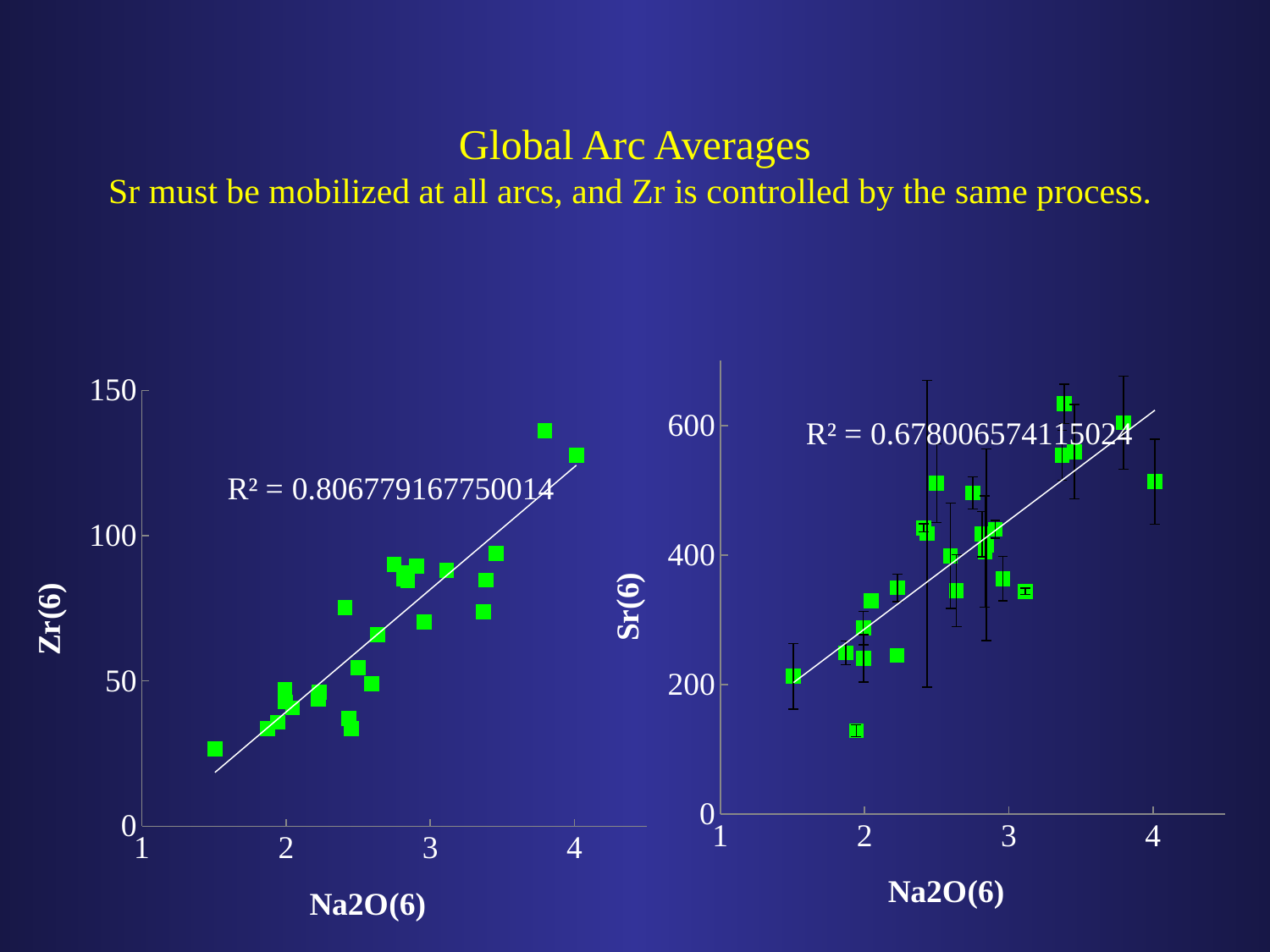
In the right chart, do the Sr(6) values generally rise or fall as Na2O(6) increases? rise In the right chart (Sr(6) vs Na2O(6)), what R² value is printed? R² = 0.678006574115024 In the right chart, is the Sr(6) value of the lowest point greater or less than 200? less In the left chart (Zr(6) vs Na2O(6)), what R² value is printed? R² = 0.806779167750014 What is the x-axis label shared by both charts? Na2O(6) Which chart has the higher printed R² value, the Zr(6) chart or the Sr(6) chart? the Zr(6) chart In the left chart, do the Zr(6) values generally rise or fall as Na2O(6) increases? rise What kind of chart is the left chart with Zr(6) on the y axis? scatter chart In the right chart, is the Sr(6) value of the highest point greater or less than 600? greater In the left chart, is the Zr(6) value of the leftmost point (near Na2O(6) = 1.5) greater or less than 50? less What kind of chart is the right chart with Sr(6) on the y axis? scatter chart